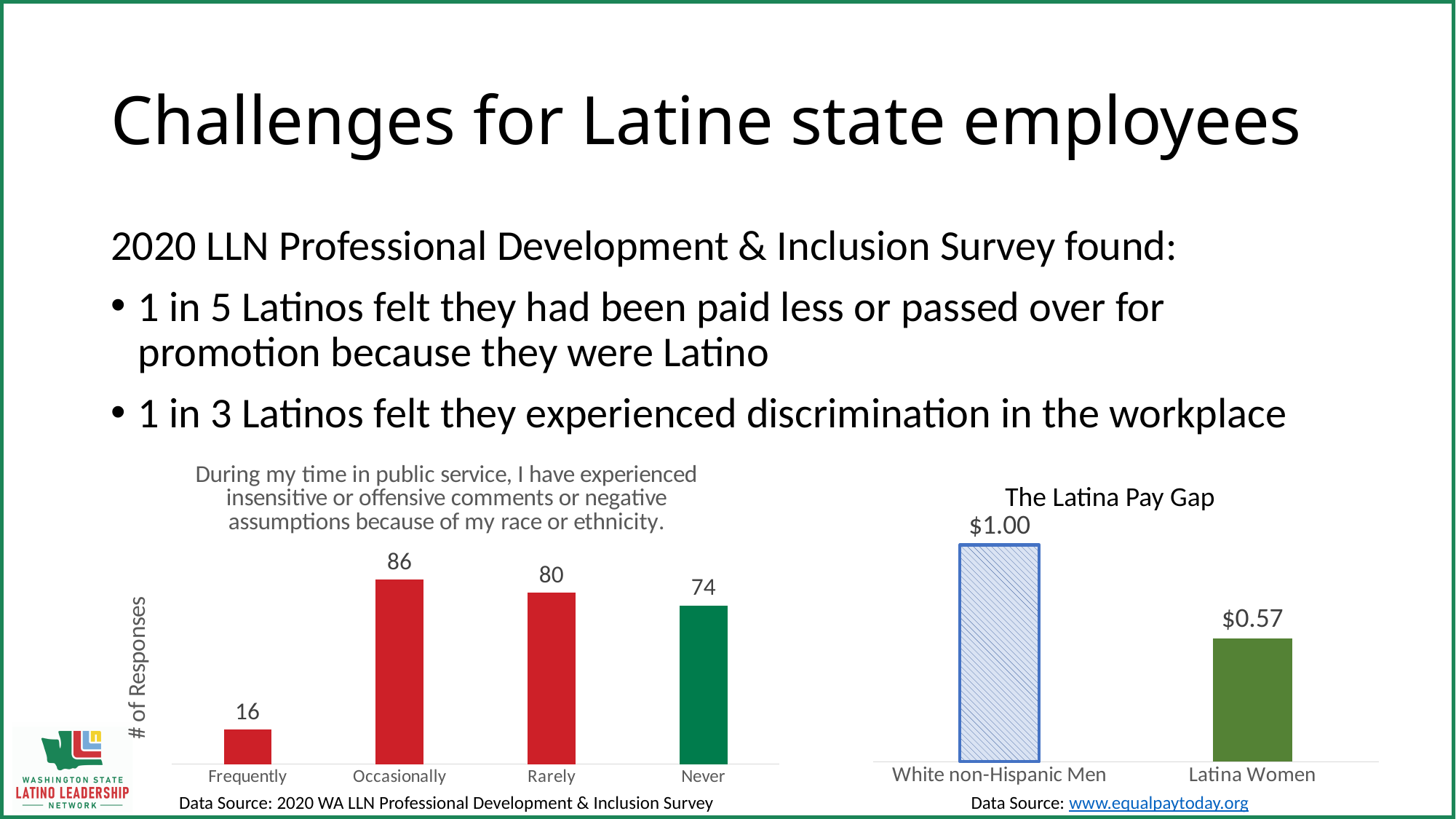
What type of chart is 'The Latina Pay Gap'? Bar chart In the left chart about insensitive or offensive comments, what is the difference in responses between 'Rarely' and 'Never'? 6 In the left chart about insensitive or offensive comments, which category has the lowest number of responses? Frequently In 'The Latina Pay Gap' chart, what is the difference between the value for White non-Hispanic Men and Latina Women? $0.43 In the left chart about insensitive or offensive comments, what is the y-axis label? # of Responses In the left chart about insensitive or offensive comments, how many responses were for 'Frequently'? 16 In 'The Latina Pay Gap' chart, what is the value for Latina Women? $0.57 In the left chart about insensitive or offensive comments, how many categories are shown? 4 In the left chart about insensitive or offensive comments, how many responses were for 'Occasionally'? 86 In 'The Latina Pay Gap' chart, what is the value for White non-Hispanic Men? $1.00 In the left chart about insensitive or offensive comments, which has more responses, 'Occasionally' or 'Rarely'? Occasionally In the left chart about insensitive or offensive comments, which category has the highest number of responses? Occasionally